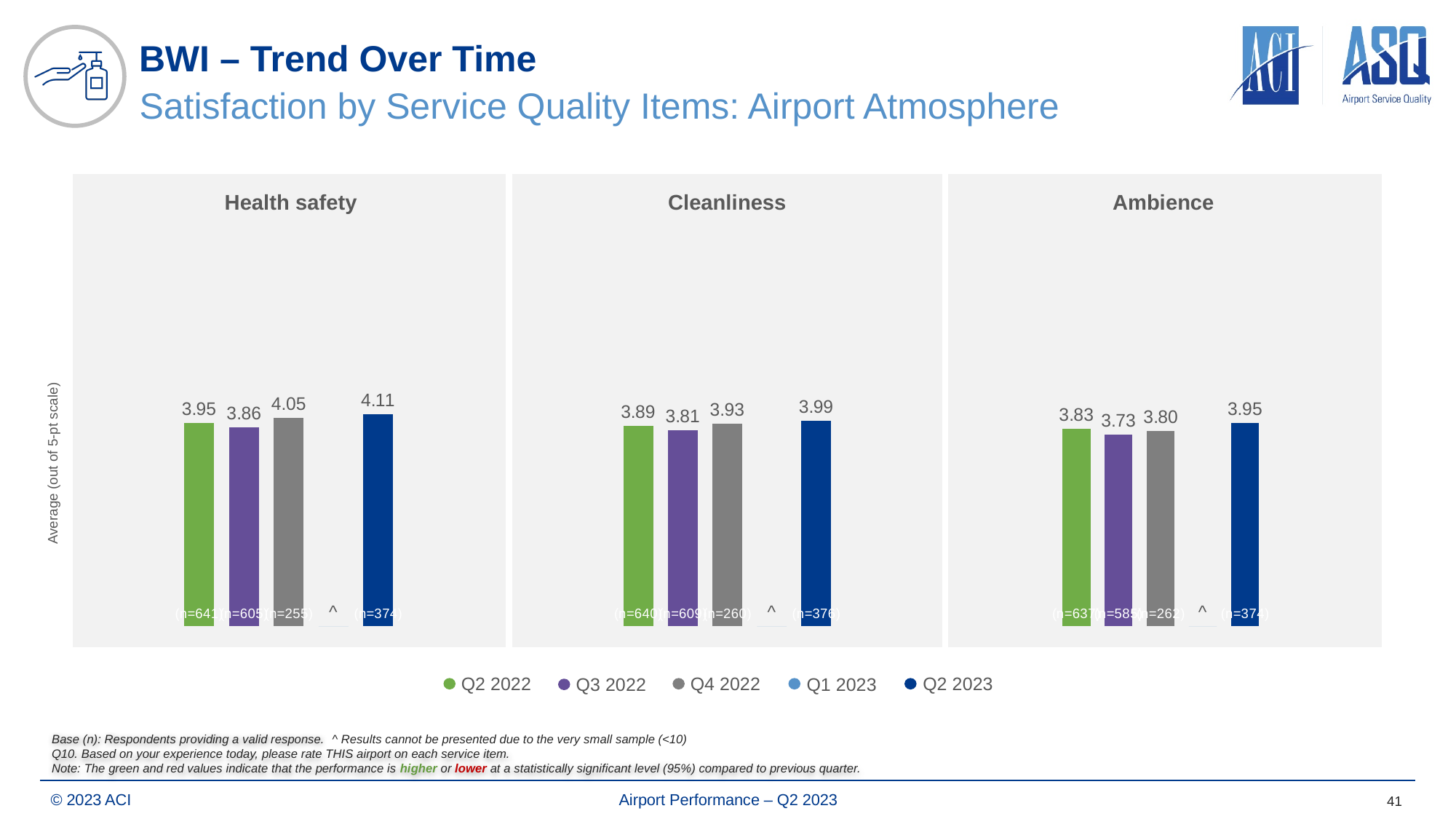
How many series does the legend list? 5 In the Ambience chart, which is larger: the value for Q2 2022 or the value for Q4 2022? Q2 2022 In the Cleanliness chart, which quarter has no bar shown because the sample was too small? Q1 2023 In the Health safety chart, which quarter has the highest value? Q2 2023 In the Ambience chart, which quarter has the lowest value? Q3 2022 What kind of chart is used on this slide? Bar chart In the Cleanliness chart, what is the difference between the Q2 2023 value and the Q2 2022 value? 0.10 In the Cleanliness chart, what is the value for Q3 2022? 3.81 In the Health safety chart, what is the difference between the Q4 2022 value and the Q3 2022 value? 0.19 In the Health safety chart, what is the value for Q2 2023? 4.11 In the Ambience chart, what is the value for Q4 2022? 3.80 What is the title of the rightmost chart? Ambience